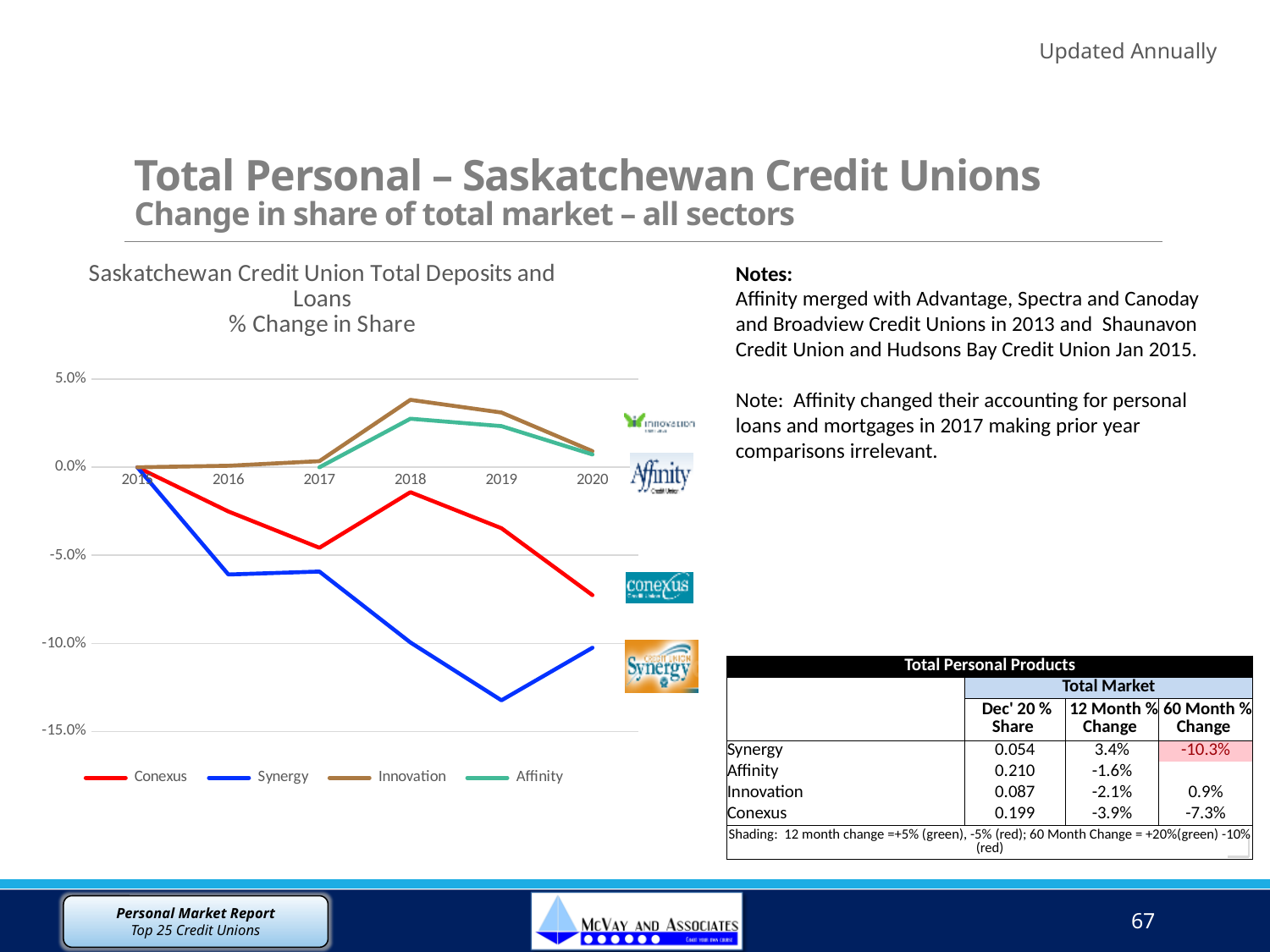
Which colour is used for the Conexus line in the chart? red Is the value for Synergy in 2019 greater or less than -10.0%? less Does the Synergy line rise or fall from 2015 to 2019? fall Is the value for Synergy in 2016 greater or less than -5.0%? less How many years are shown along the x axis of the chart? 6 Is the value for Conexus in 2020 greater or less than -5.0%? less What kind of chart is shown on the slide? line chart Which credit union has the highest % change in share in 2018? Innovation In 2018, which is larger: the value for Conexus or the value for Synergy? Conexus How many series does the chart legend list? 4 Which credit union has the lowest % change in share in 2019? Synergy